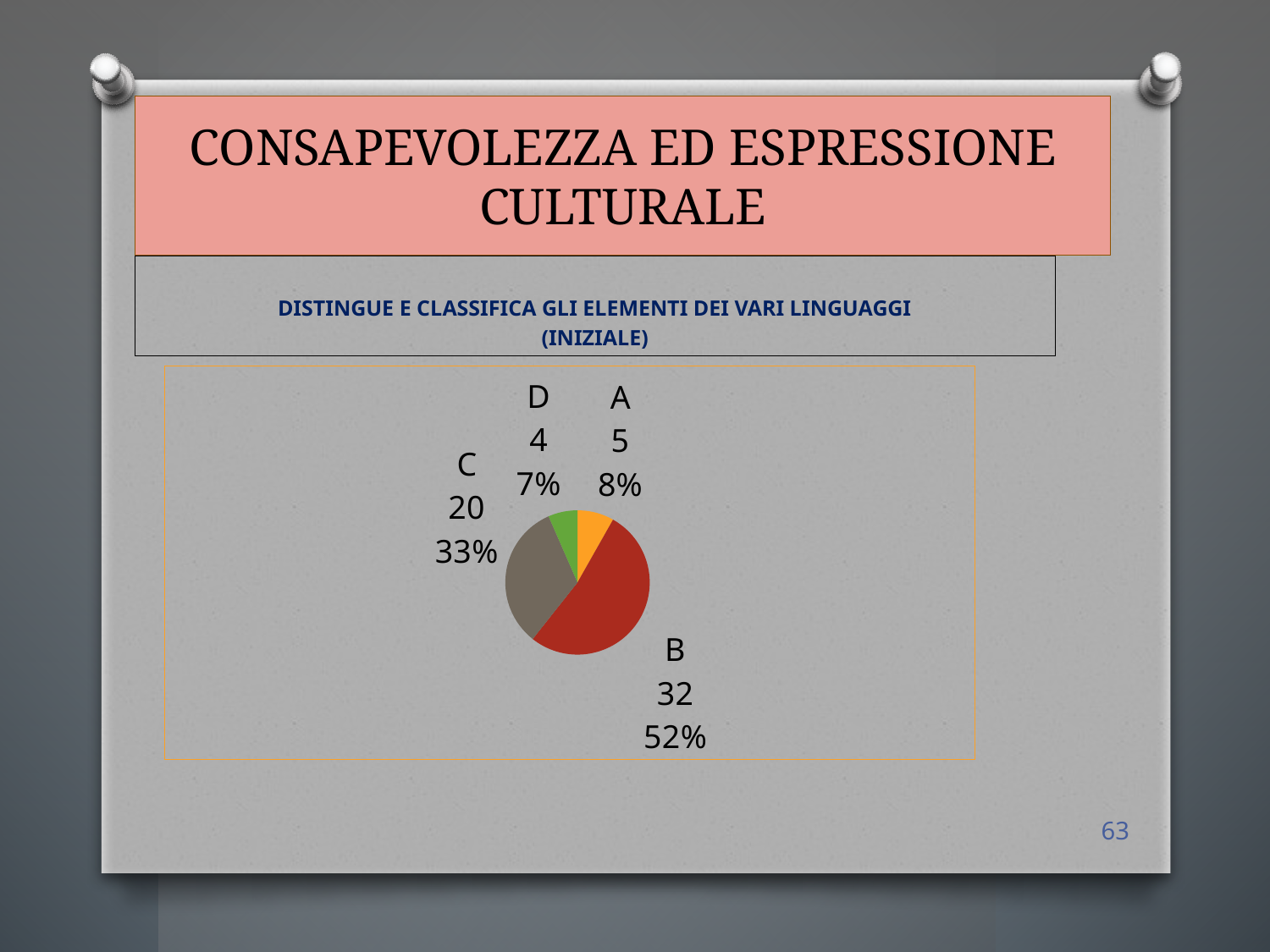
Which category has the largest slice? B Which is larger, the value for A or the value for D? A What share of the pie does category C represent? 33% What is the value for category D? 4 Which category has the smallest slice? D What kind of chart is shown on the slide? pie chart What is the difference between the values for B and C? 12 How many categories are shown in the pie chart? 4 What share of the pie does category A represent? 8% What is the value for category B? 32 What is the value for category A? 5 What is the value for category C? 20